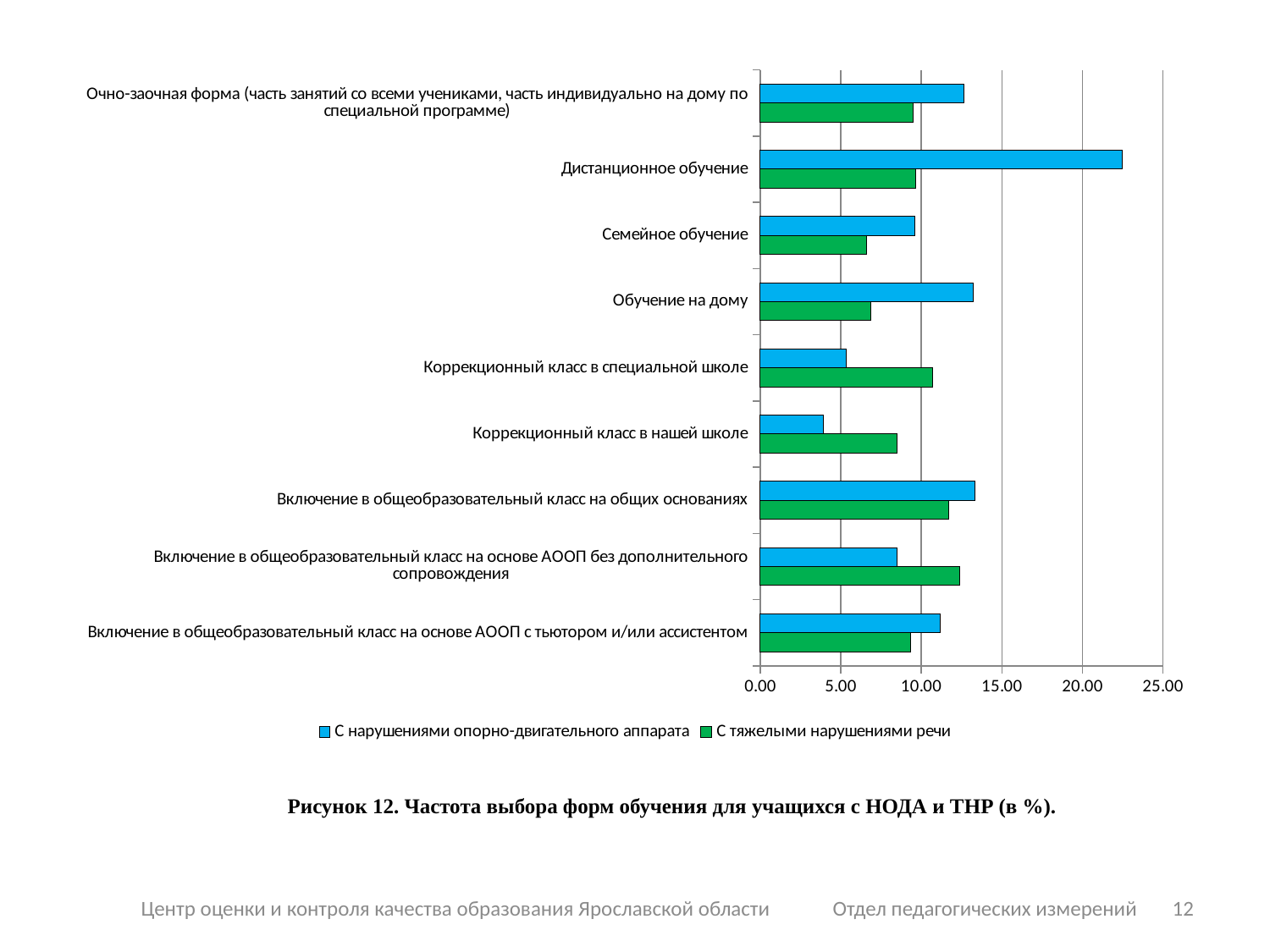
How many series does the legend list? 2 Which colour represents the series 'С тяжелыми нарушениями речи' in the chart? green For 'Коррекционный класс в специальной школе', which series has the larger value: 'С нарушениями опорно-двигательного аппарата' or 'С тяжелыми нарушениями речи'? С тяжелыми нарушениями речи For the series 'С нарушениями опорно-двигательного аппарата', which category has the highest value? Дистанционное обучение How many forms of education (categories) are shown on the chart? 9 Is the value for 'Дистанционное обучение' in the series 'С нарушениями опорно-двигательного аппарата' greater or less than 20.00? greater For 'Дистанционное обучение', which series has the larger value: 'С нарушениями опорно-двигательного аппарата' or 'С тяжелыми нарушениями речи'? С нарушениями опорно-двигательного аппарата Is the value for 'Семейное обучение' in the series 'С тяжелыми нарушениями речи' greater or less than 10.00? less What kind of chart is shown on the slide? bar chart Is the value for 'Коррекционный класс в нашей школе' in the series 'С нарушениями опорно-двигательного аппарата' greater or less than 5.00? less For the series 'С нарушениями опорно-двигательного аппарата', which category has the lowest value? Коррекционный класс в нашей школе